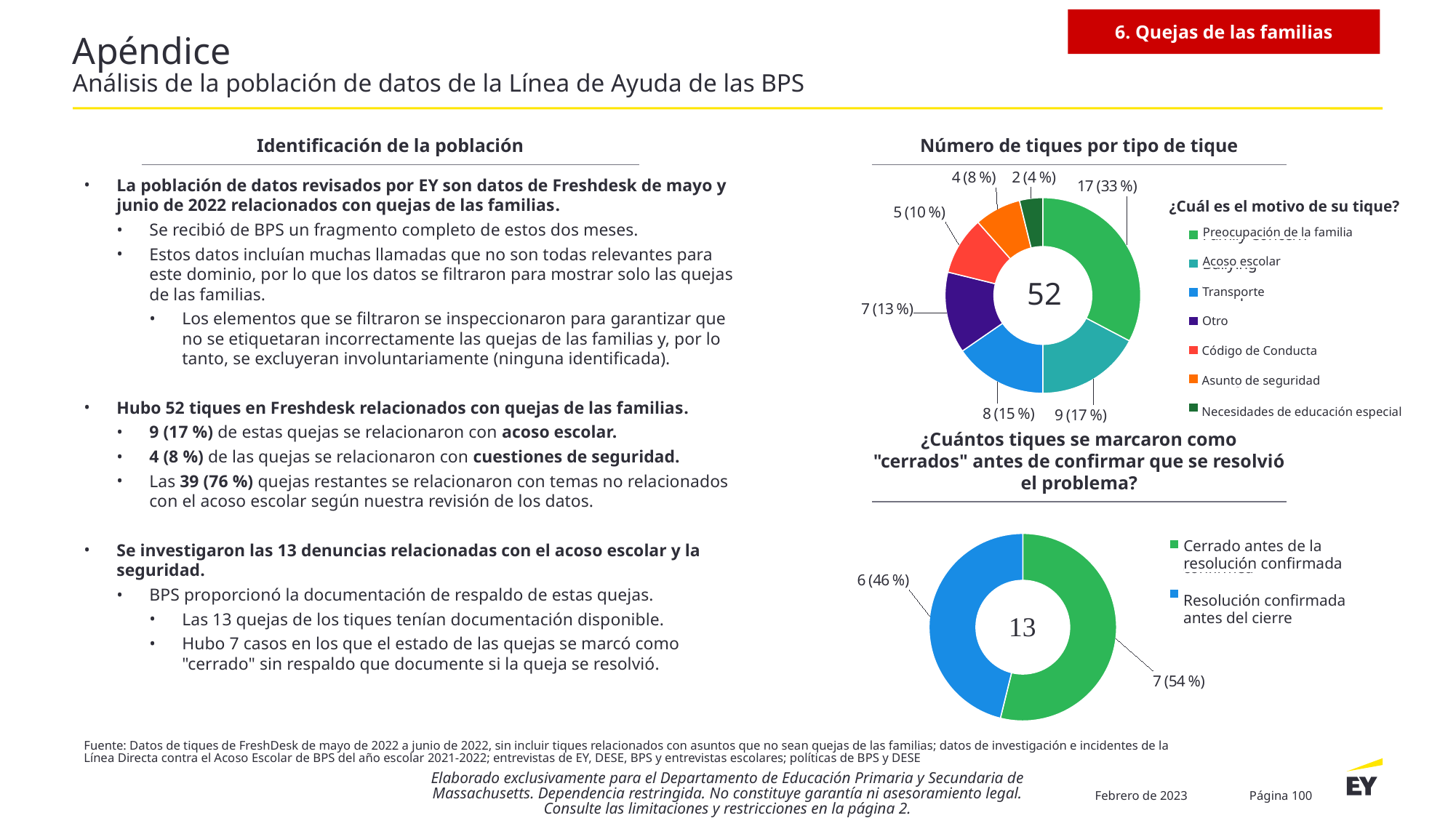
In the chart 'Número de tiques por tipo de tique', what is the difference in ticket count between Preocupación de la familia and Otro? 10 In the chart 'Número de tiques por tipo de tique', which ticket type has the most tickets? Preocupación de la familia In the chart '¿Cuántos tiques se marcaron como "cerrados" antes de confirmar que se resolvió el problema?', how many tickets were 'Cerrado antes de la resolución confirmada'? 7 (54 %) In the chart 'Número de tiques por tipo de tique', how many tickets are for Transporte? 8 (15 %) In the chart 'Número de tiques por tipo de tique', what share of tickets is Asunto de seguridad? 8 % In the chart 'Número de tiques por tipo de tique', which has more tickets: Código de Conducta or Asunto de seguridad? Código de Conducta What type of chart is used for '¿Cuántos tiques se marcaron como "cerrados" antes de confirmar que se resolvió el problema?'? Donut (pie) chart In the chart 'Número de tiques por tipo de tique', how many tickets are for Acoso escolar? 9 (17 %) What number is shown in the centre of the chart 'Número de tiques por tipo de tique'? 52 In the chart 'Número de tiques por tipo de tique', which ticket type has the fewest tickets? Necesidades de educación especial In the chart '¿Cuántos tiques se marcaron como "cerrados" antes de confirmar que se resolvió el problema?', what share of tickets is 'Resolución confirmada antes del cierre'? 46 % In the chart 'Número de tiques por tipo de tique', how many ticket types are shown? 7